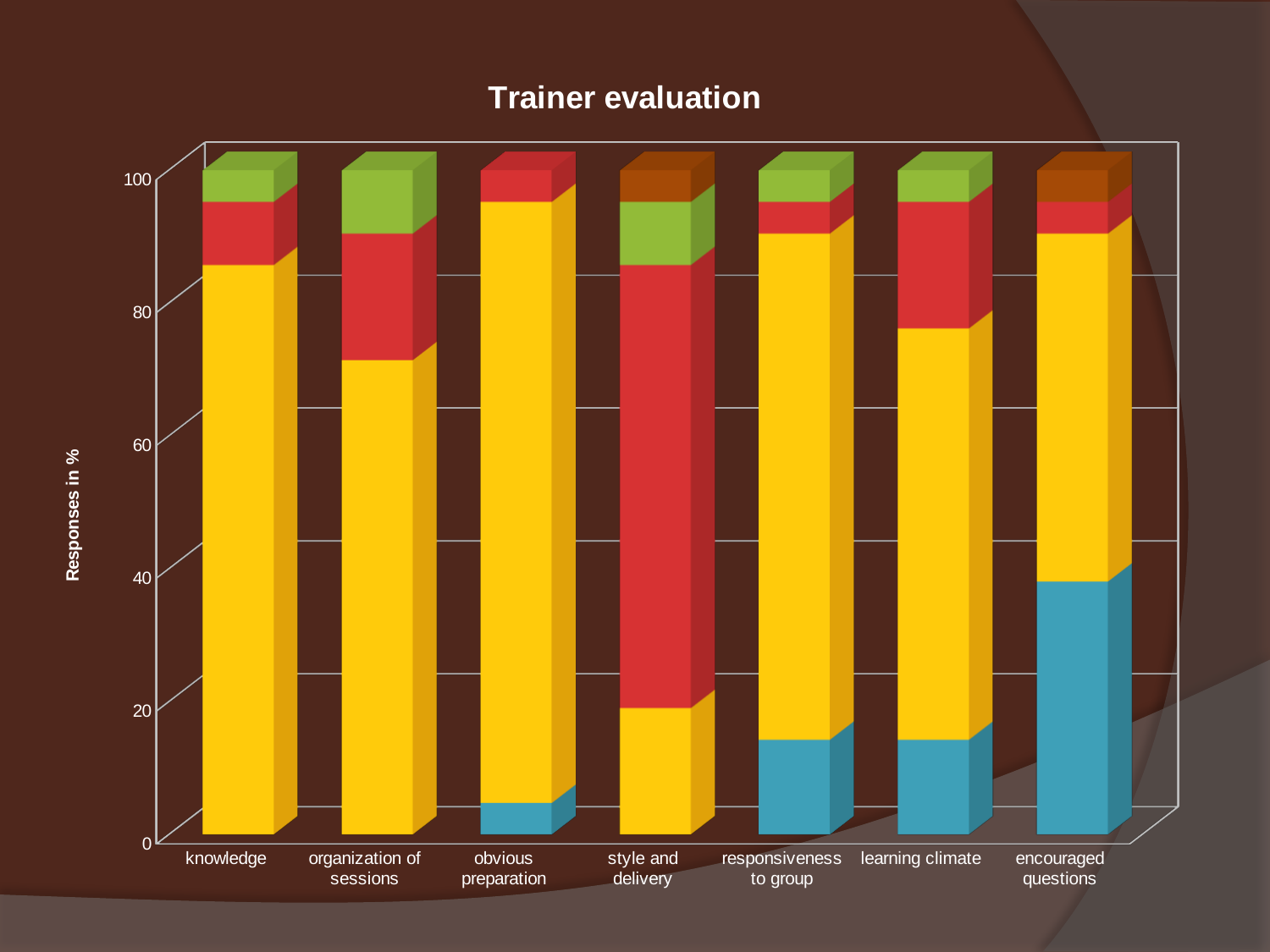
What is the title of the chart? Trainer evaluation What kind of chart is shown on the slide? stacked bar chart Which category has the larger blue segment, "encouraged questions" or "obvious preparation"? encouraged questions What is the label of the vertical axis? Responses in % Which category has the larger red segment, "style and delivery" or "knowledge"? style and delivery How many categories include a blue segment in their bar? 4 How many categories are shown on the x axis of the chart? 7 Which category has the smallest yellow segment? style and delivery Is the yellow segment for "obvious preparation" greater or less than 80? greater Is the blue segment for "encouraged questions" greater or less than 20? greater Which category has the largest red segment? style and delivery Is the yellow segment for "style and delivery" greater or less than 40? less